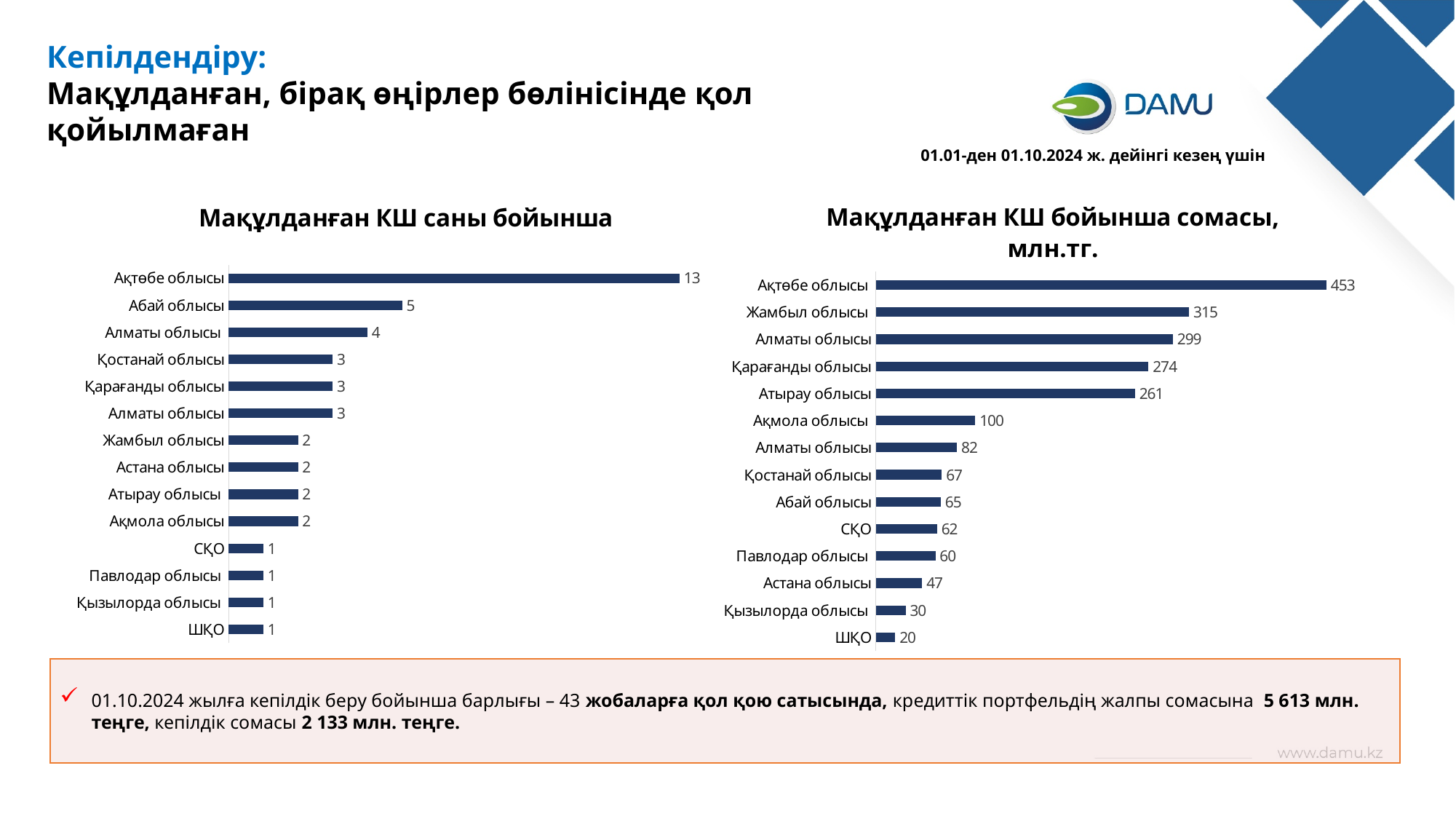
In the chart 'Мақұлданған КШ бойынша сомасы, млн.тг.', which region has the lowest value? ШҚО In the chart 'Мақұлданған КШ бойынша сомасы, млн.тг.', what is the value for Қызылорда облысы? 30 What type of chart is 'Мақұлданған КШ бойынша сомасы, млн.тг.'? Bar chart In the chart 'Мақұлданған КШ бойынша сомасы, млн.тг.', what is the value for Жамбыл облысы? 315 In the chart 'Мақұлданған КШ саны бойынша', what is the value for Ақтөбе облысы? 13 In the chart 'Мақұлданған КШ бойынша сомасы, млн.тг.', what is the difference between Ақтөбе облысы and Жамбыл облысы? 138 In the chart 'Мақұлданған КШ саны бойынша', what is the value for Абай облысы? 5 In the chart 'Мақұлданған КШ бойынша сомасы, млн.тг.', which is larger: Атырау облысы or Ақмола облысы? Атырау облысы In the chart 'Мақұлданған КШ саны бойынша', what is the difference between Ақтөбе облысы and Абай облысы? 8 In the chart 'Мақұлданған КШ саны бойынша', how many regions are listed? 14 In the chart 'Мақұлданған КШ бойынша сомасы, млн.тг.', what is the value for Қарағанды облысы? 274 In the chart 'Мақұлданған КШ саны бойынша', which region has the highest value? Ақтөбе облысы